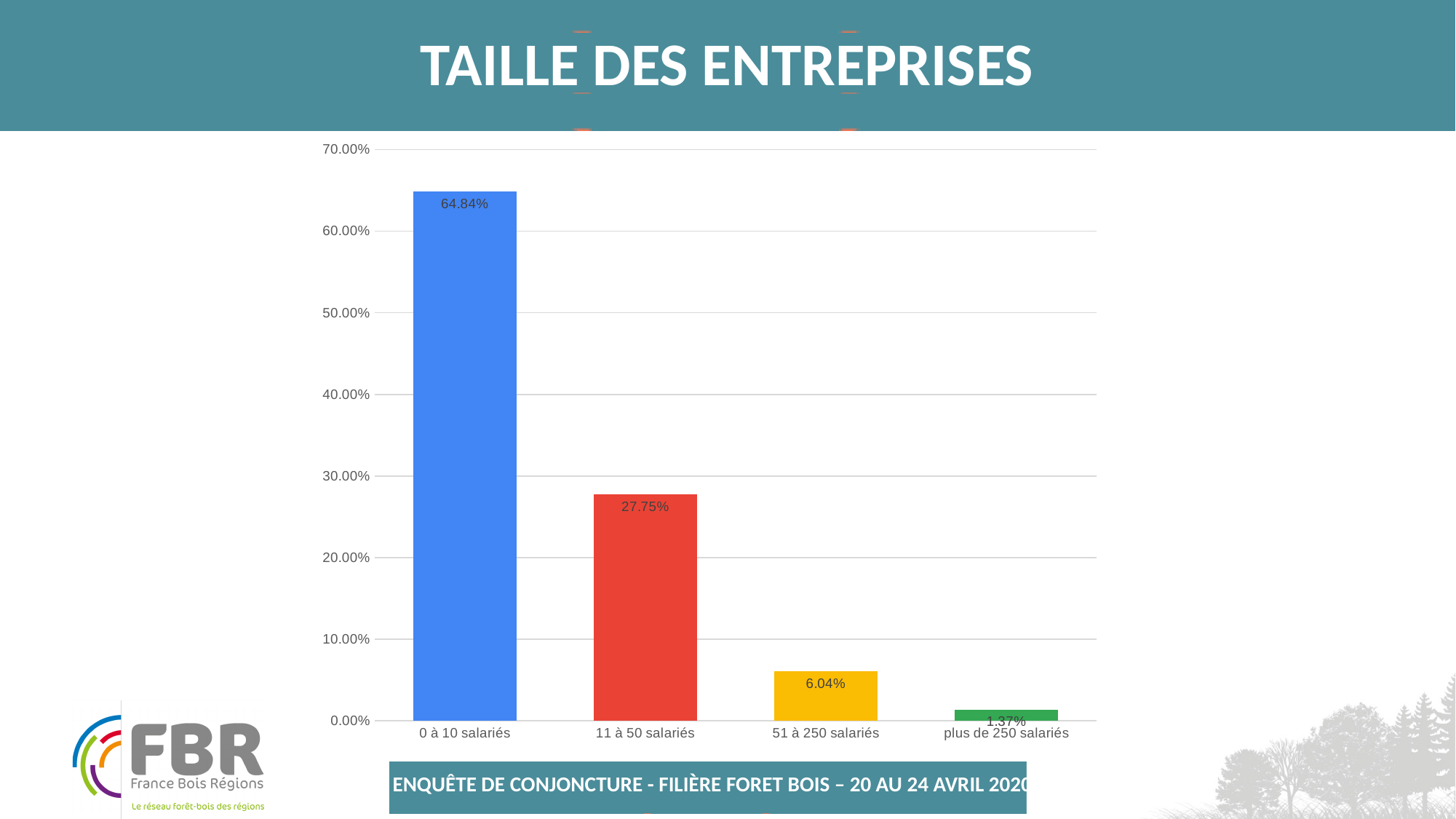
What kind of chart is shown on the slide? bar chart What is the value for "plus de 250 salariés"? 1.37% What is the title of the slide containing the chart? TAILLE DES ENTREPRISES What is the value for "51 à 250 salariés"? 6.04% What is the value for "0 à 10 salariés"? 64.84% How many categories are shown on the x axis? 4 Which category has the highest value? 0 à 10 salariés What is the value for "11 à 50 salariés"? 27.75% Which category has the lowest value? plus de 250 salariés What is the difference between the values for "0 à 10 salariés" and "11 à 50 salariés"? 37.09% Which is larger, the value for "51 à 250 salariés" or "plus de 250 salariés"? 51 à 250 salariés Is the value for "11 à 50 salariés" greater or less than 30.00%? less